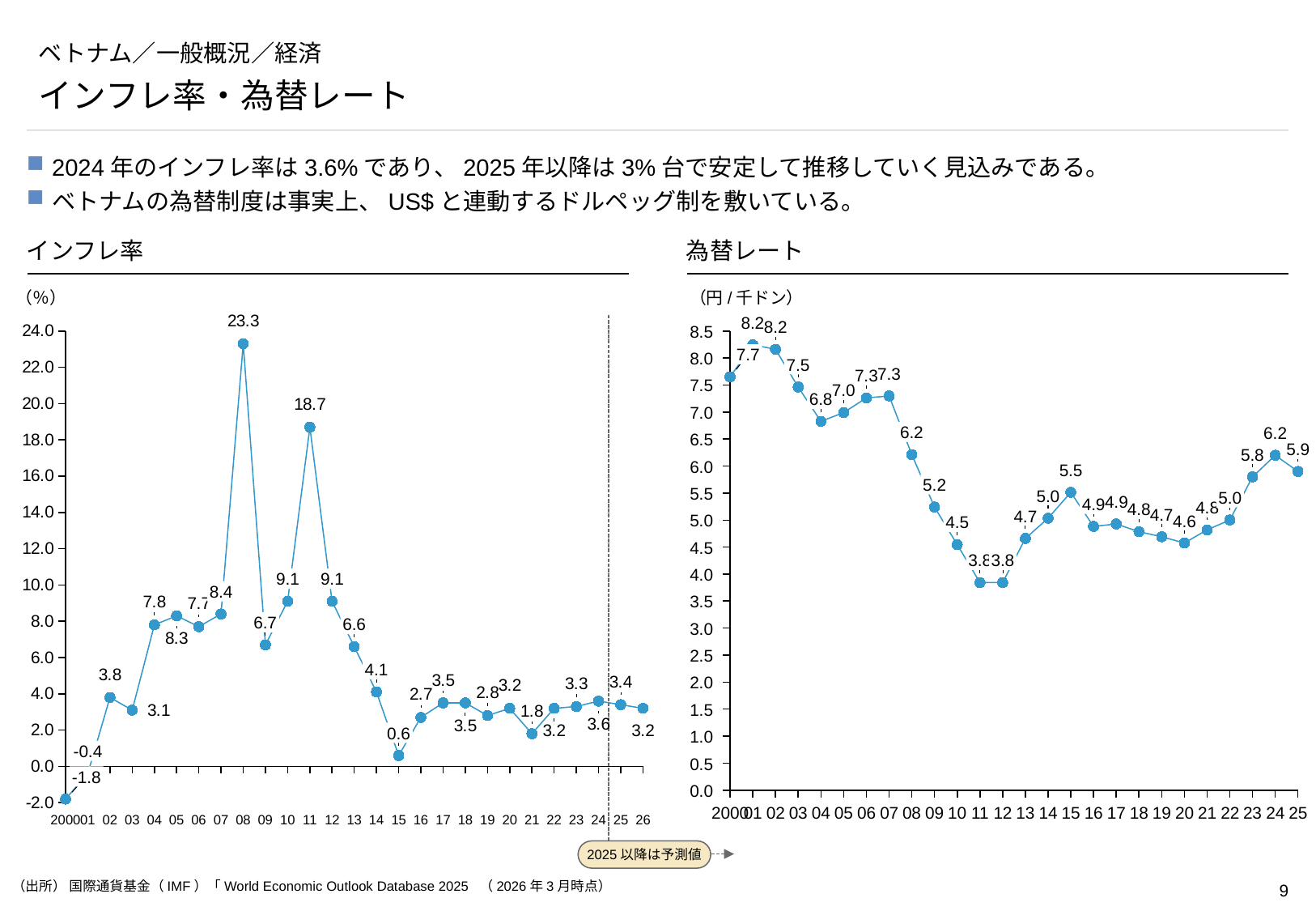
What unit is shown on the 為替レート chart's axis? 円/千ドン On the インフレ率 chart, what is the inflation rate for 2008? 23.3 On the インフレ率 chart, what is the inflation rate for 2024? 3.6 On the 為替レート chart, what is the value for 2011? 3.8 On the 為替レート chart, which is larger, the value for 2024 or the value for 2025? 2024 On the 為替レート chart, what is the value for 2015? 5.5 On the インフレ率 chart, which year has the highest inflation rate? 2008 On the 為替レート chart, what is the difference between the 2024 value and the 2025 value? 0.3 What kind of chart is the 為替レート chart? line chart On the インフレ率 chart, what is the difference between the 2008 value and the 2011 value? 4.6 On the インフレ率 chart, do the values rise or fall from 2021 to 2024? rise On the インフレ率 chart, which year has the lowest inflation rate? 2000